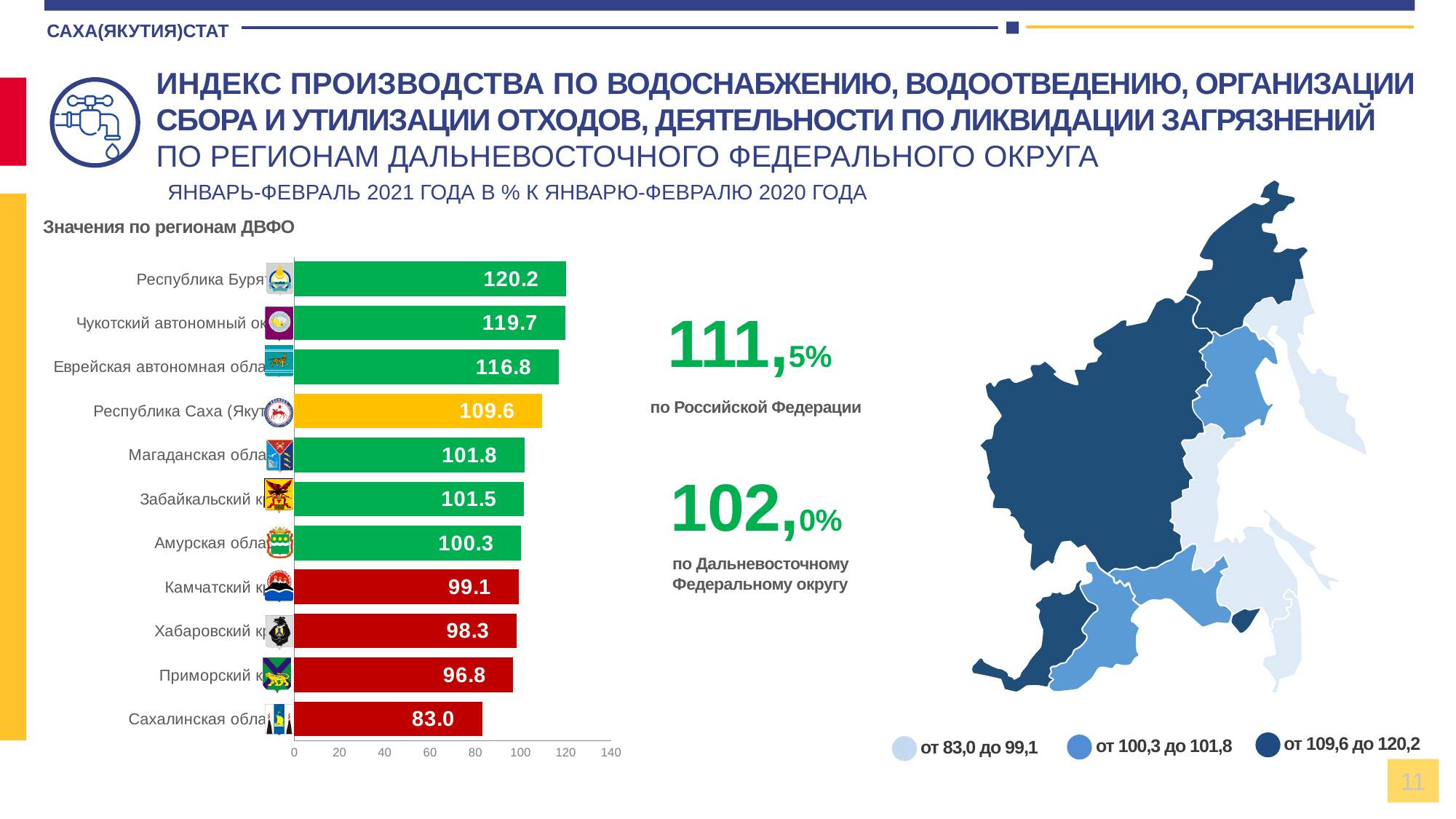
What kind of chart is used to show the values by region? bar chart Which is larger: the value for Камчатский край or the value for Хабаровский край? Камчатский край What is the difference between the values for Республика Бурятия and Сахалинская область? 37.2 What colour is the bar for Республика Саха (Якутия)? yellow Which region has the highest value in the bar chart? Республика Бурятия Which region has the lowest value in the bar chart? Сахалинская область What value is shown for the Russian Federation (по Российской Федерации) on the slide? 111,5% How many regions are shown in the bar chart? 11 What is the value for Магаданская область in the bar chart? 101.8 What is the value for Сахалинская область in the bar chart? 83.0 What is the value for Республика Саха (Якутия) in the bar chart? 109.6 What is the difference between the values for Чукотский автономный округ and Еврейская автономная область? 2.9